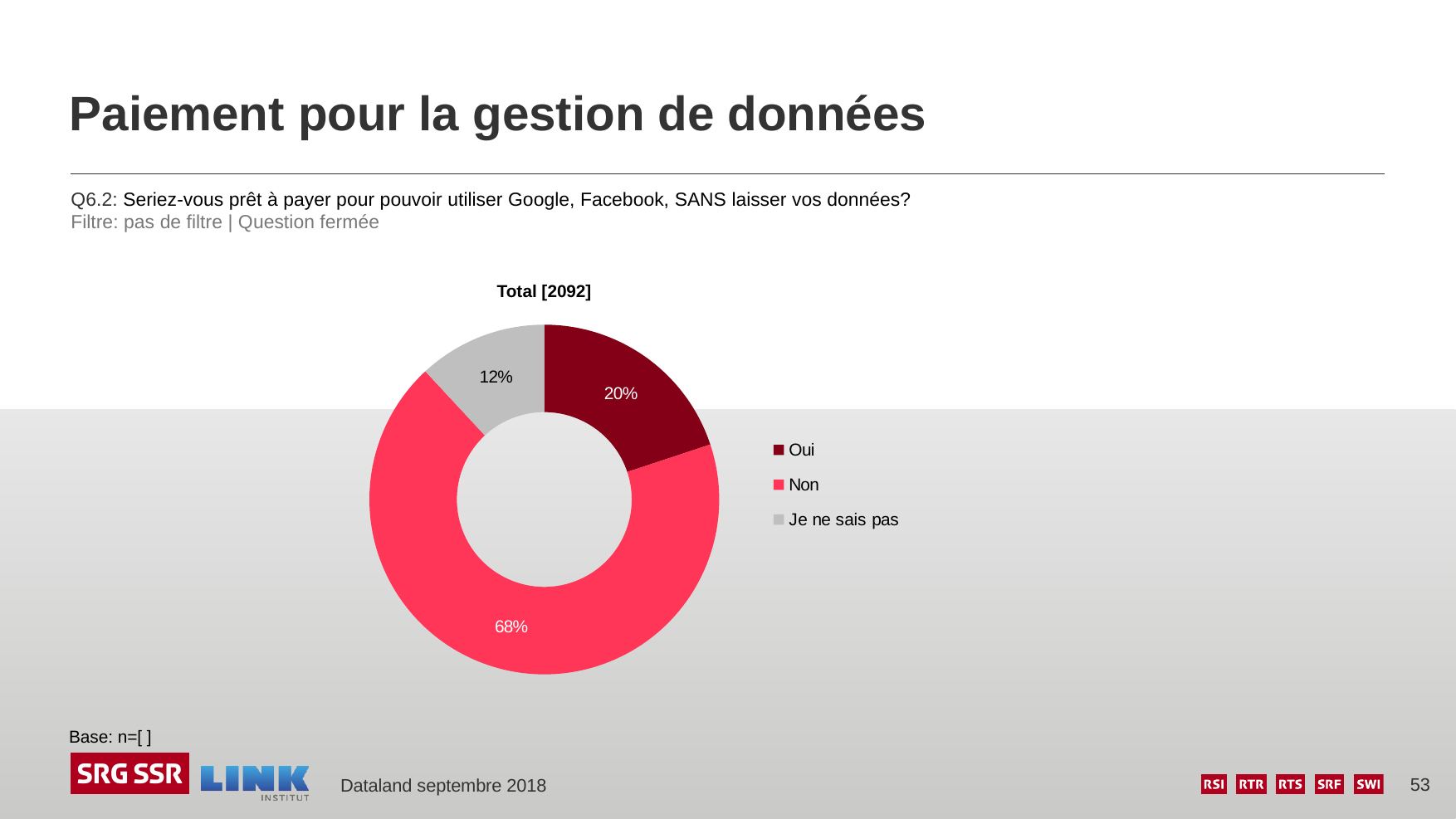
What is the title of the chart? Total [2092] What is the difference in percentage points between "Non" and "Oui"? 48 How many categories does the chart show? 3 Which response category has the smallest share? Je ne sais pas What percentage of respondents answered "Oui"? 20% What kind of chart is shown on the slide? Doughnut chart Which response category has the largest share? Non What colour is the "Non" segment in the chart? Red Which is larger, the share for "Oui" or the share for "Je ne sais pas"? Oui What percentage of respondents answered "Non"? 68% What is the difference in percentage points between "Oui" and "Je ne sais pas"? 8 What percentage of respondents answered "Je ne sais pas"? 12%